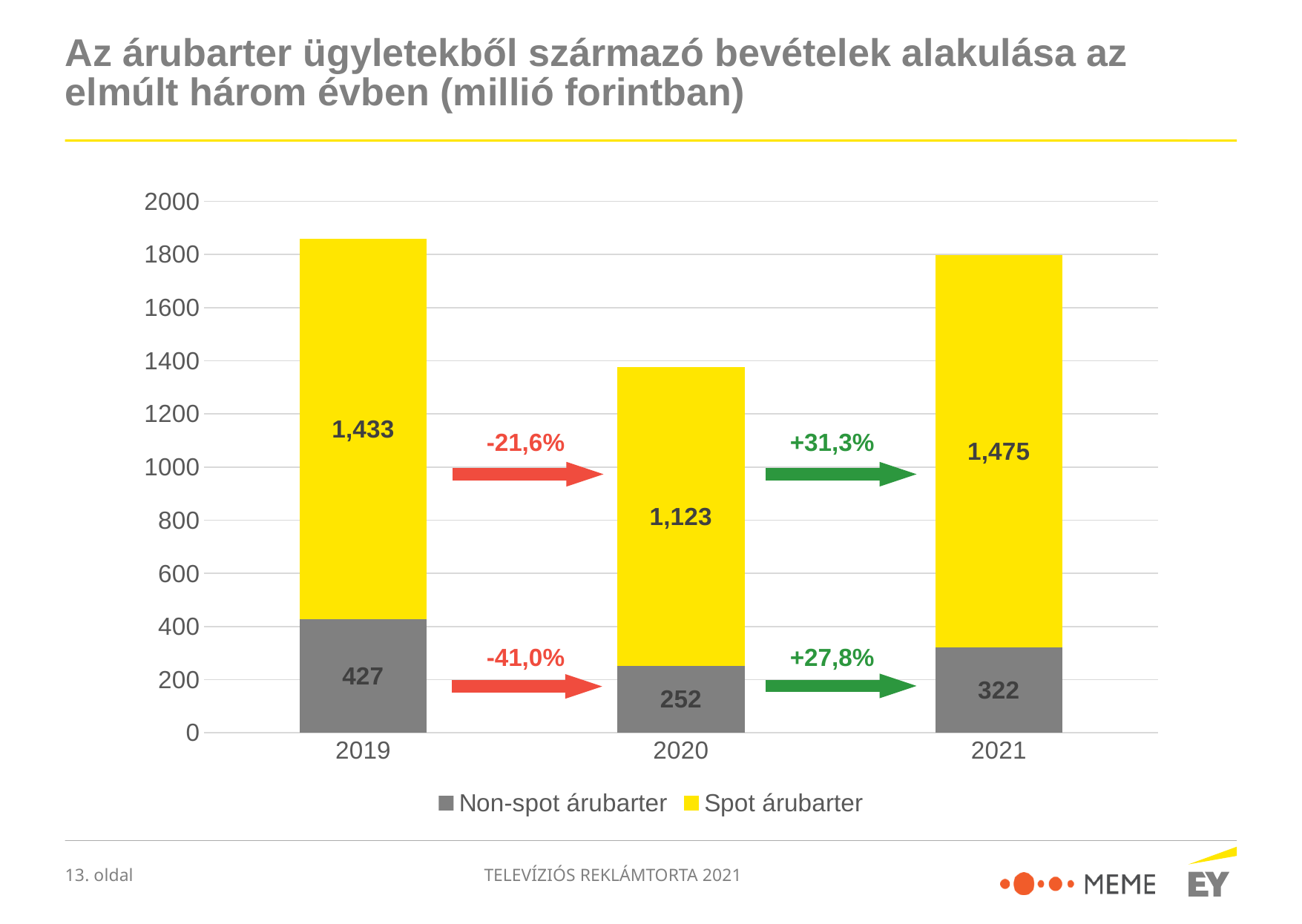
Which year has the highest Spot árubarter value? 2021 What is the total of the stacked bar for 2020? 1,375 Is the Non-spot árubarter value for 2019 larger or smaller than the Non-spot árubarter value for 2021? larger What percentage change is shown by the arrow between the Spot árubarter values for 2020 and 2021? +31,3% What is the value of Non-spot árubarter in 2021? 322 What type of chart is shown on the slide? stacked bar chart How many years are shown on the x axis? 3 What is the value of Spot árubarter in 2020? 1,123 How many series does the legend list? 2 Which year has the lowest Non-spot árubarter value? 2020 What is the total of the stacked bar for 2019? 1,860 What is the difference between the Non-spot árubarter values for 2019 and 2020? 175